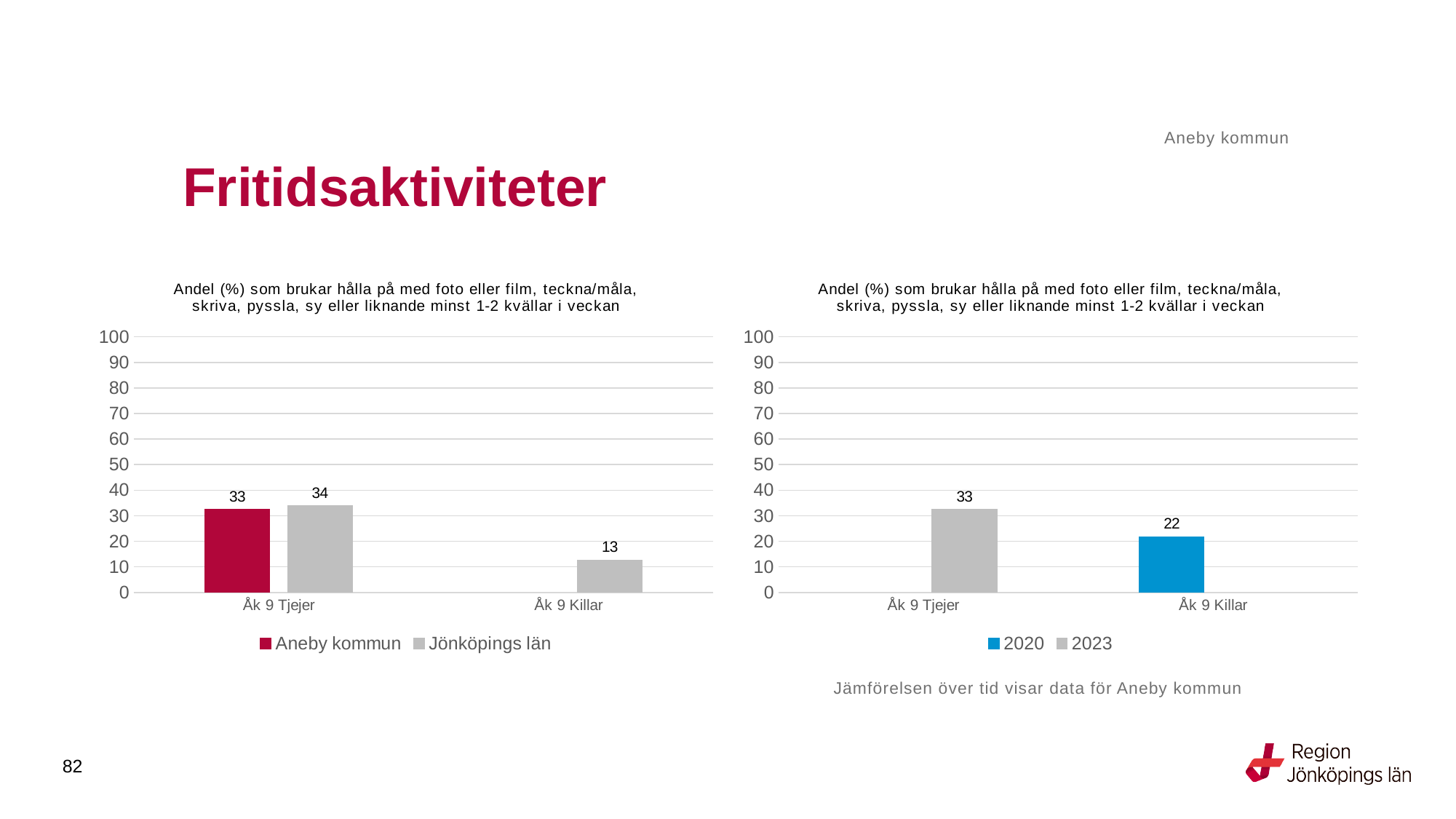
In the left chart, is the value for Jönköpings län for Åk 9 Killar greater or less than 20? less In the left chart, how many series does the legend list? 2 In the right chart, what is the value for 2020 for Åk 9 Killar? 22 In the right chart, how many categories are shown on the x axis? 2 In the right chart, what is the difference between the Åk 9 Tjejer value and the Åk 9 Killar value? 11 In the left chart, what is the difference between the Jönköpings län values for Åk 9 Tjejer and Åk 9 Killar? 21 In the right chart, what is the value for 2023 for Åk 9 Tjejer? 33 What kind of chart is the right chart? bar chart In the left chart, what is the value for Aneby kommun for Åk 9 Tjejer? 33 In the left chart, which is larger for Åk 9 Tjejer: Aneby kommun or Jönköpings län? Jönköpings län In the left chart, what is the value for Jönköpings län for Åk 9 Killar? 13 In the right chart, which colour represents 2020 in the legend? blue